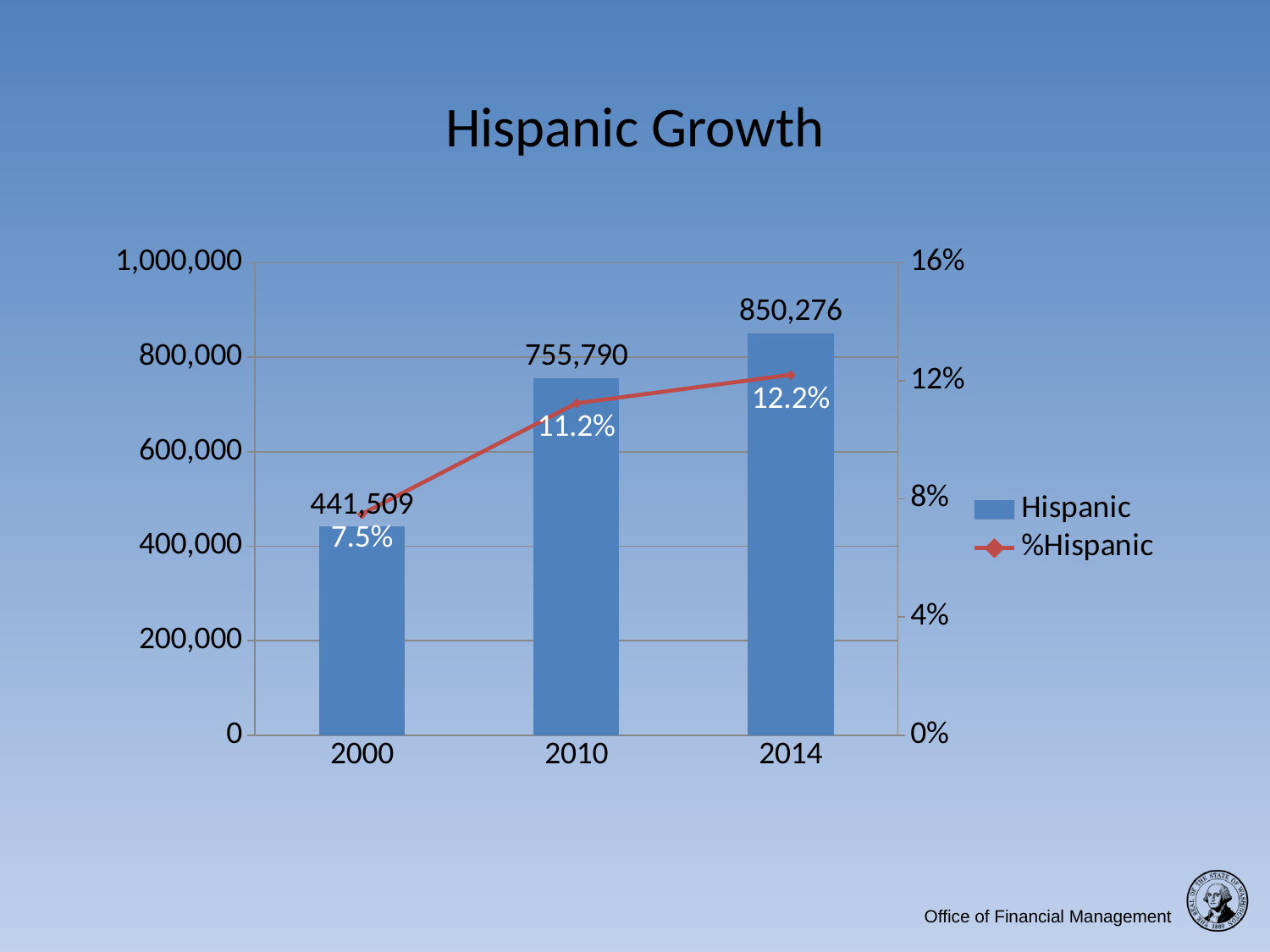
What is the Hispanic population value for 2014? 850,276 Which is larger, the Hispanic population in 2010 or in 2000? 2010 What is the Hispanic population value for 2010? 755,790 What is the %Hispanic value for 2000? 7.5% Which year has the highest Hispanic population? 2014 Does the %Hispanic line rise or fall from 2000 to 2014? Rise How many years are shown on the x axis? 3 What is the difference between the Hispanic population in 2014 and in 2000? 408,767 What is the difference between the %Hispanic values for 2014 and 2010? 1.0% What kind of chart is this? Combined bar and line chart Which year has the lowest %Hispanic value? 2000 How many series does the legend list? 2